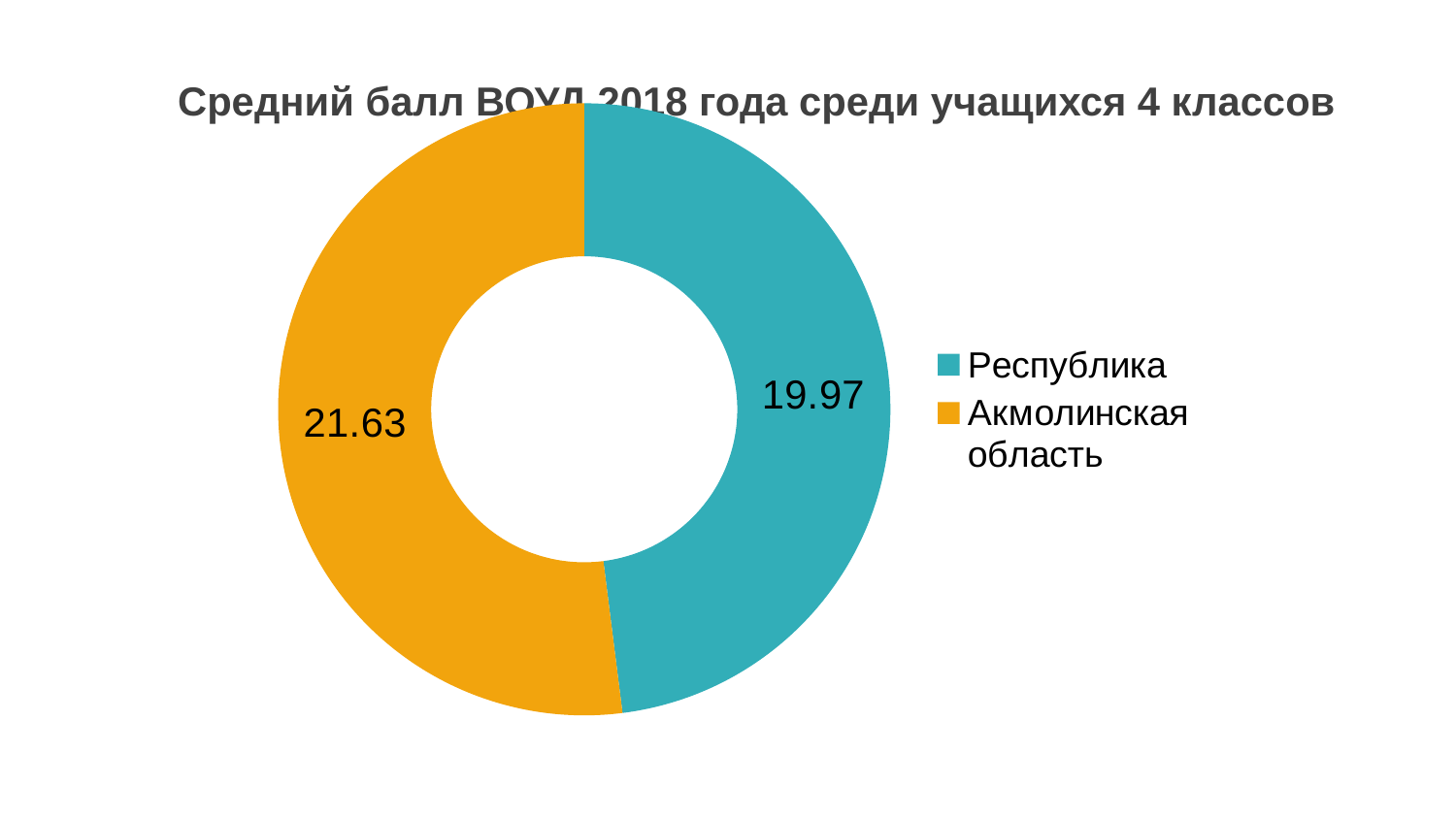
What is the value shown for Республика? 19.97 How many entries does the legend list? 2 Which category has the larger value? Акмолинская область Which category has the smaller value? Республика What kind of chart is shown on the slide? doughnut chart What is the title of the chart? Средний балл ВОУД 2018 года среди учащихся 4 классов What is the sum of the two values shown in the chart? 41.60 What is the difference between the values for Акмолинская область and Республика? 1.66 Which colour represents Акмолинская область in the chart? orange Is the value for Республика larger or smaller than the value for Акмолинская область? smaller How many categories are shown in the chart? 2 What is the value shown for Акмолинская область? 21.63